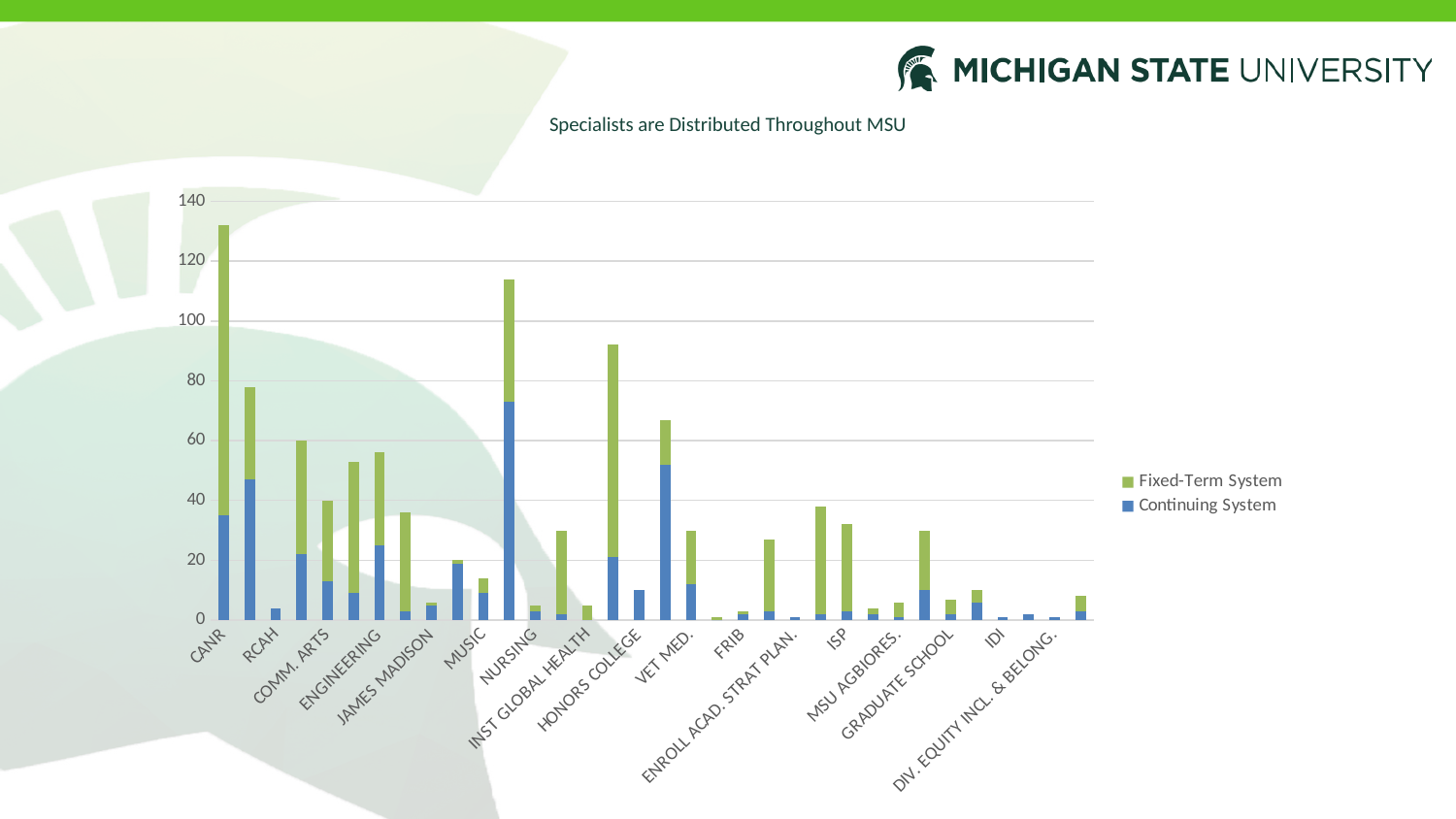
What kind of chart is shown on the slide? Stacked bar chart Which has the larger Continuing System value, CANR or NURSING? CANR Is the total stacked value for CANR greater or less than 120? greater Is the total stacked value for VET MED. greater or less than 60? less How many series does the legend list? 2 Is the total stacked value for NURSING greater or less than 100? less What are the two series named in the legend? Fixed-Term System and Continuing System What is the title of the chart? Specialists are Distributed Throughout MSU Which has the larger total stacked bar, CANR or NURSING? CANR Which category has the tallest stacked bar overall? CANR